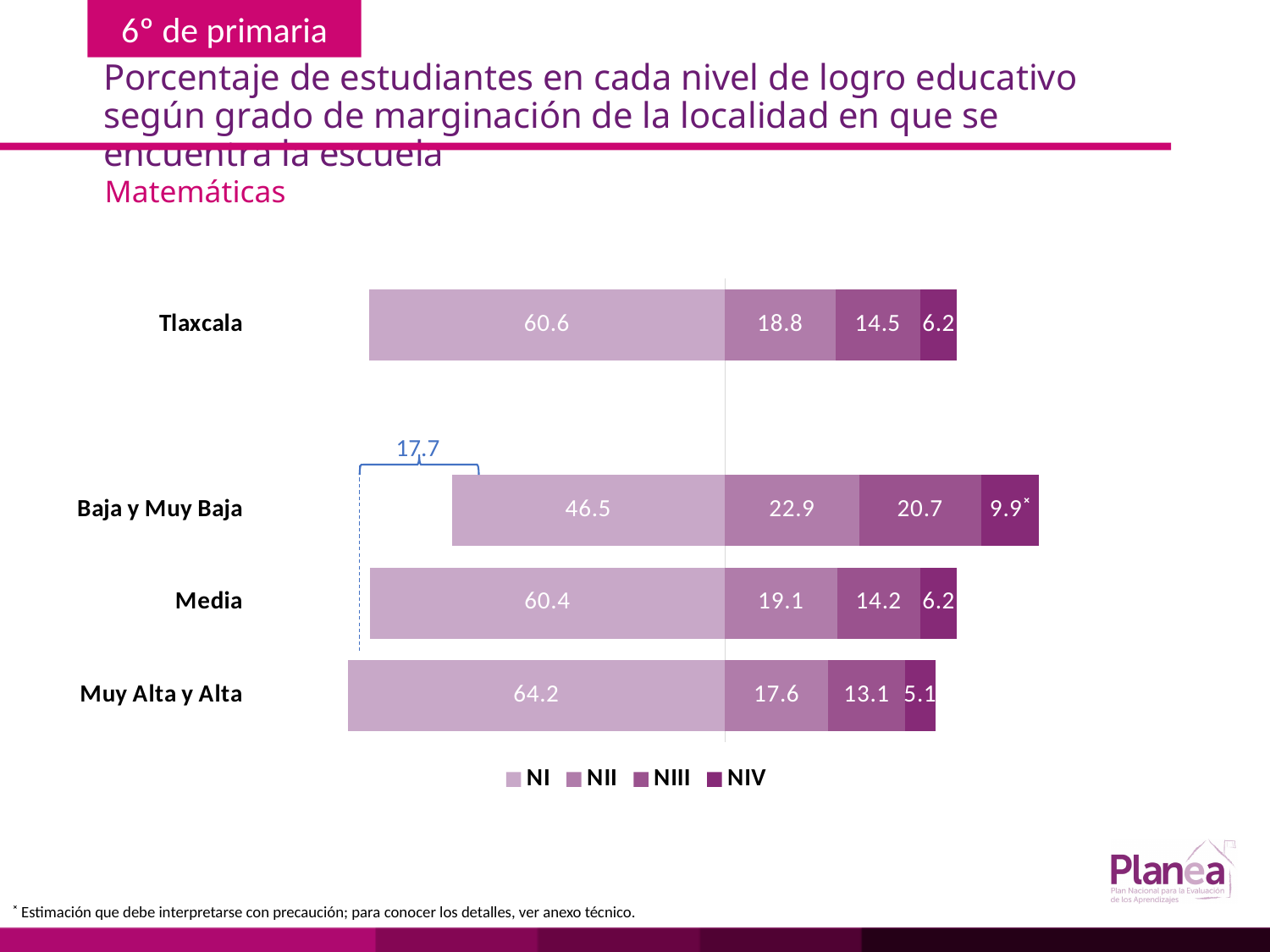
What type of chart is shown on the slide? Stacked bar chart Which category has the highest NI value? Muy Alta y Alta How many series does the legend list? 4 What is the NI value for Tlaxcala? 60.6 How many categories (bars) are shown in the chart? 4 What is the NIII value for Baja y Muy Baja? 20.7 What is the NII value for Media? 19.1 What is the difference between the NI value for Muy Alta y Alta and the NI value for Baja y Muy Baja? 17.7 Which category has the lowest NI value? Baja y Muy Baja What is the NIV value for Muy Alta y Alta? 5.1 Which is larger, the NII value for Baja y Muy Baja or the NII value for Tlaxcala? Baja y Muy Baja What is the total of the stacked bar for Baja y Muy Baja? 100.0